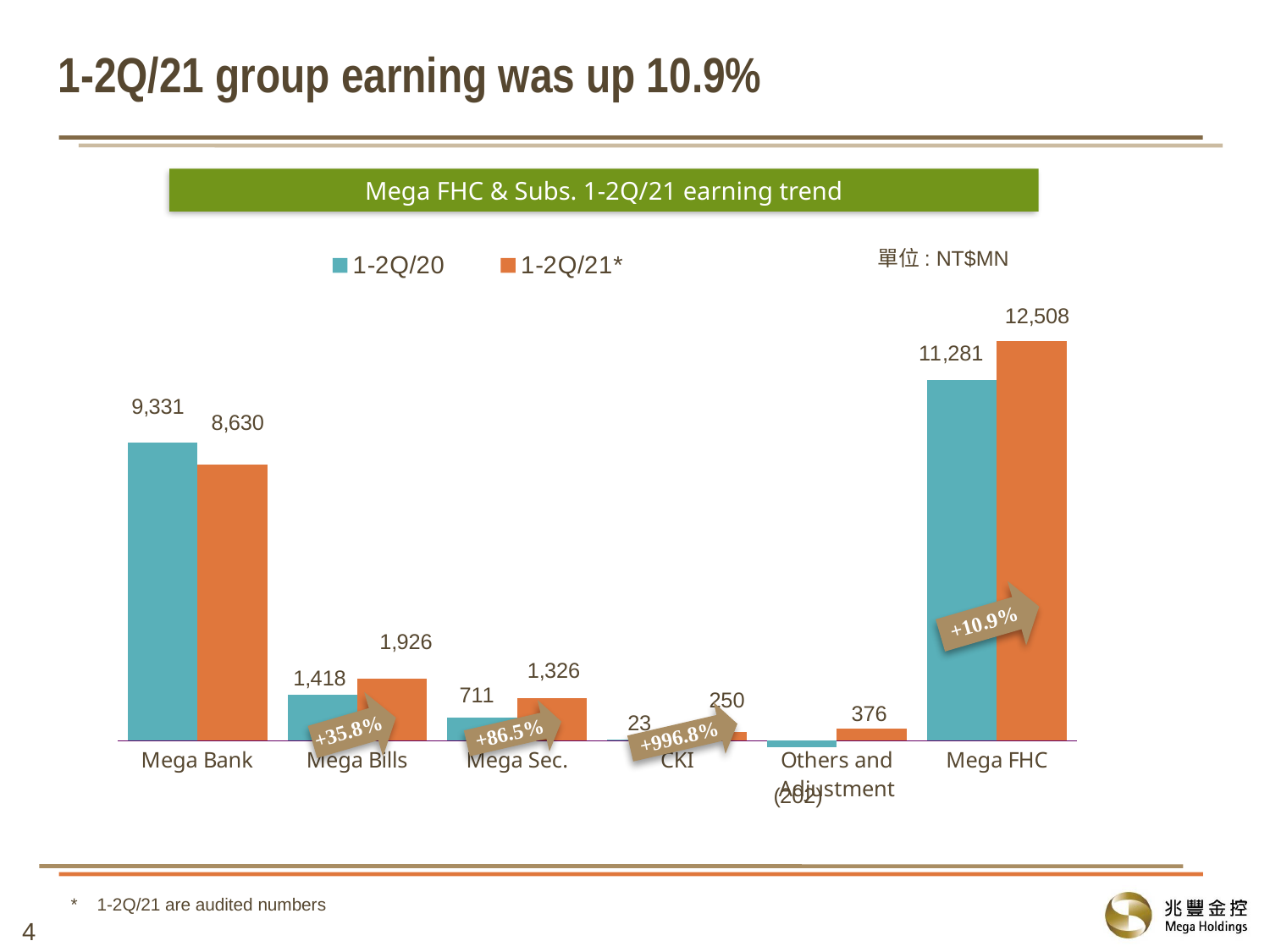
Which category has the lowest 1-2Q/21* value? CKI What is the 1-2Q/21* value for Mega Sec.? 1,326 What is the 1-2Q/21* value for Mega Bank? 8,630 What kind of chart is shown on the slide? Bar chart Which category has the highest 1-2Q/21* value? Mega FHC What is the difference between the 1-2Q/21* and 1-2Q/20 values for Mega Bills? 508 What is the 1-2Q/20 value for CKI? 23 What is the title of the chart? Mega FHC & Subs. 1-2Q/21 earning trend What is the 1-2Q/20 value for Mega FHC? 11,281 How many series does the legend list? 2 Which is larger for Mega Bank: the 1-2Q/20 value or the 1-2Q/21* value? 1-2Q/20 How many categories are shown on the x axis? 6